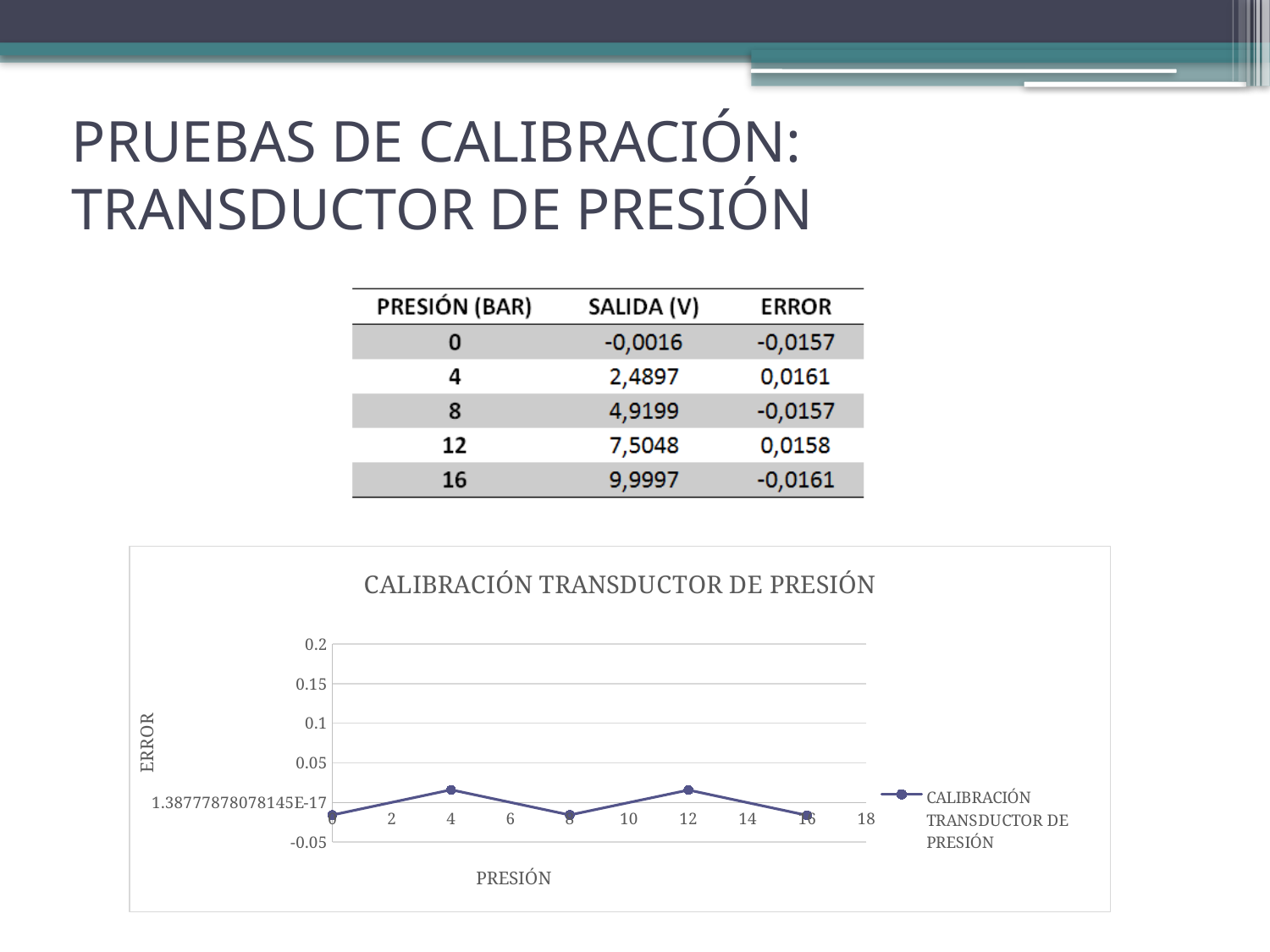
Is the value plotted at PRESIÓN 16 greater or less than -0.05? greater How many series does the chart's legend list? 1 Is the value plotted at PRESIÓN 12 greater or less than 0.1? less How many data points are plotted on the chart? 5 Which is larger on the chart: the value at PRESIÓN 12 or the value at PRESIÓN 16? PRESIÓN 12 What is the title of the chart? CALIBRACIÓN TRANSDUCTOR DE PRESIÓN What is the label of the chart's vertical axis? ERROR What kind of chart is shown on the slide? Line chart What is the highest tick value shown on the chart's vertical axis? 0.2 Is the value plotted at PRESIÓN 4 greater or less than 0.05? less Which is larger on the chart: the value at PRESIÓN 4 or the value at PRESIÓN 8? PRESIÓN 4